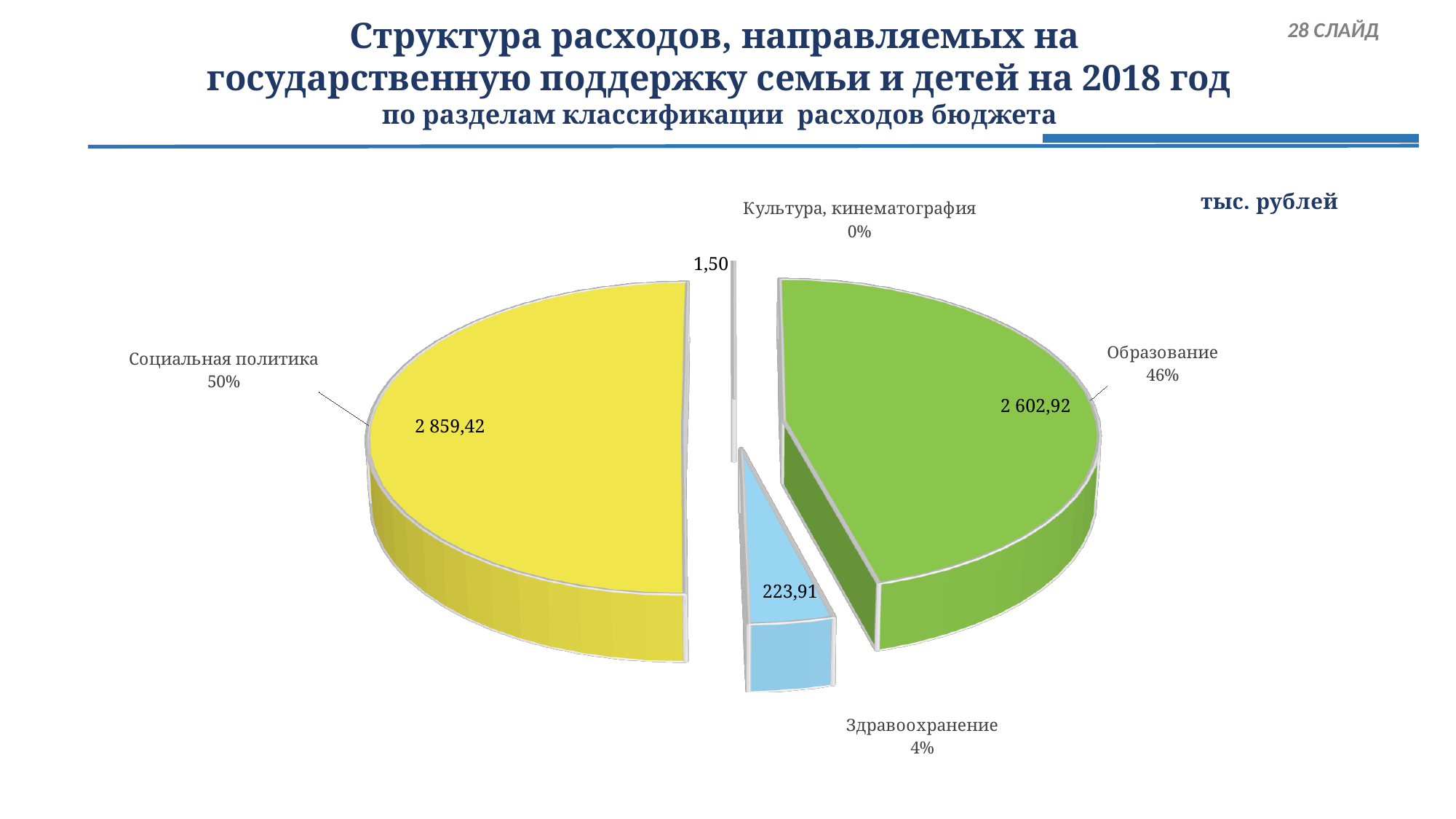
What kind of chart is shown on the slide? Pie chart What is the difference between the values for Социальная политика and Образование? 256,50 What is the value for Социальная политика? 2 859,42 How many slices does the pie chart have? 4 What is the value for Культура, кинематография? 1,50 What is the value for Здравоохранение? 223,91 What share of the pie does Образование represent? 46% In what units are the values on the chart given? тыс. рублей What is the value for Образование? 2 602,92 What share of the pie does Здравоохранение represent? 4% Which category has the smallest slice of the pie? Культура, кинематография Which category has the largest slice of the pie? Социальная политика